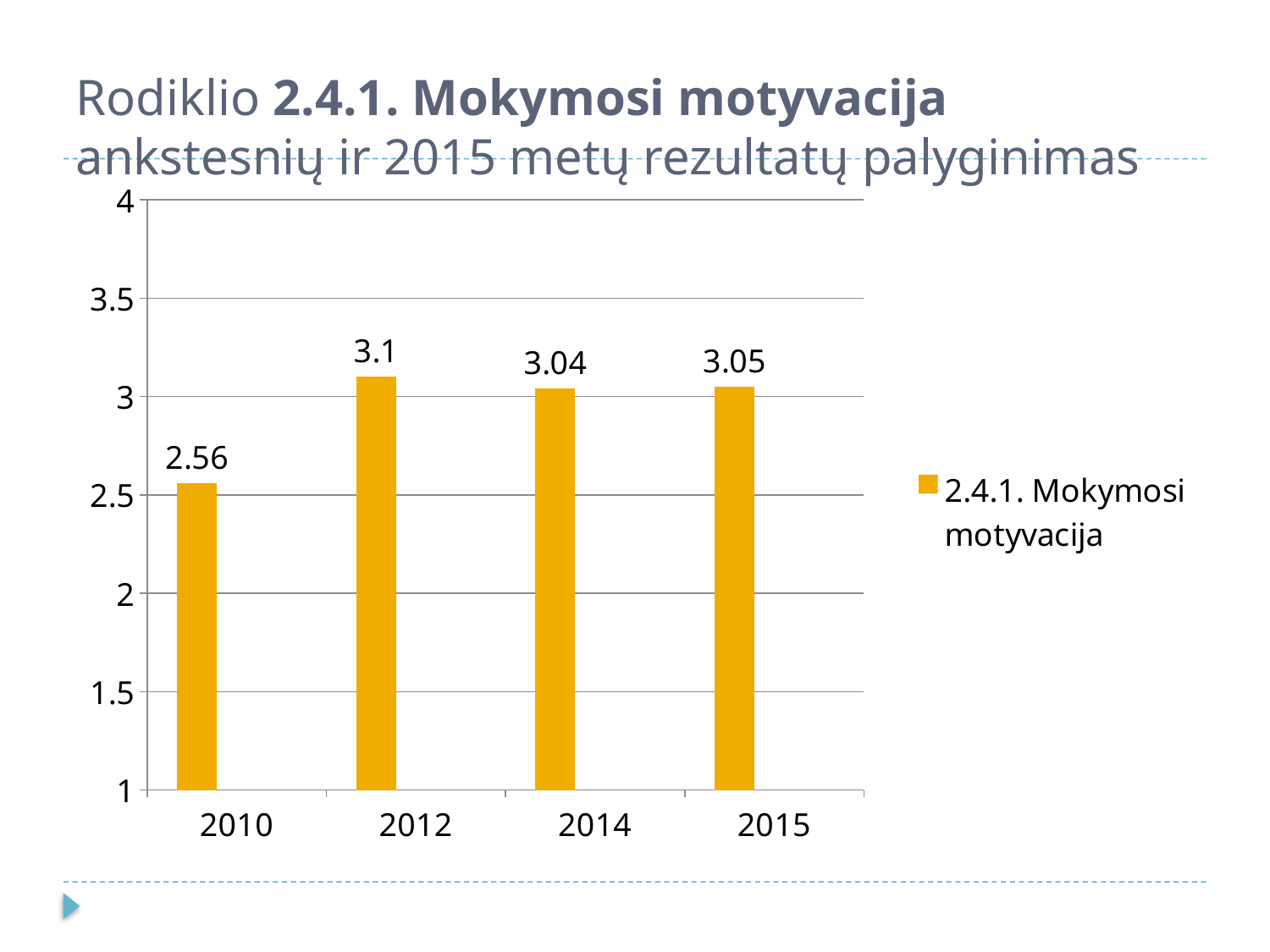
What kind of chart is shown? bar chart Which year has the lowest value? 2010 What is the value for 2015? 3.05 What is the value for 2012? 3.1 What is the value for 2010? 2.56 Is the value for 2010 greater or less than 3? less How many series does the legend list? 1 How many years are shown on the x axis? 4 What is the value for 2014? 3.04 What is the difference between the values for 2012 and 2010? 0.54 Which year has the highest value? 2012 Which is larger, the value for 2010 or the value for 2014? 2014